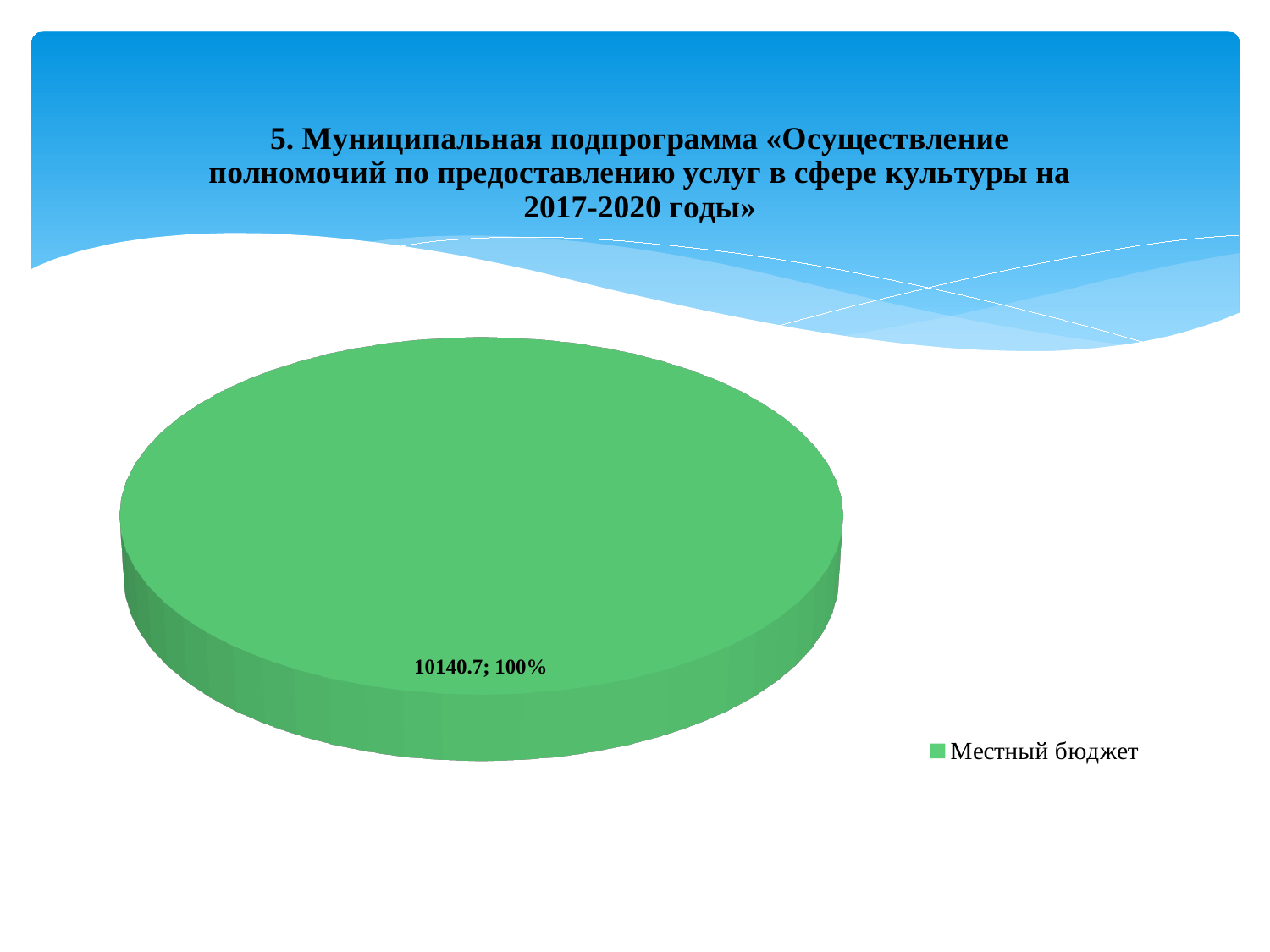
How many entries does the legend list? 1 How many slices does the pie chart have? 1 What is the title of the slide containing the chart? 5. Муниципальная подпрограмма «Осуществление полномочий по предоставлению услуг в сфере культуры на 2017-2020 годы» What kind of chart is shown on the slide? pie chart What share of the pie does Местный бюджет represent? 100% What is the value shown for Местный бюджет? 10140.7 Is the value for Местный бюджет greater or less than 10000? greater What is the legend entry for the green slice? Местный бюджет